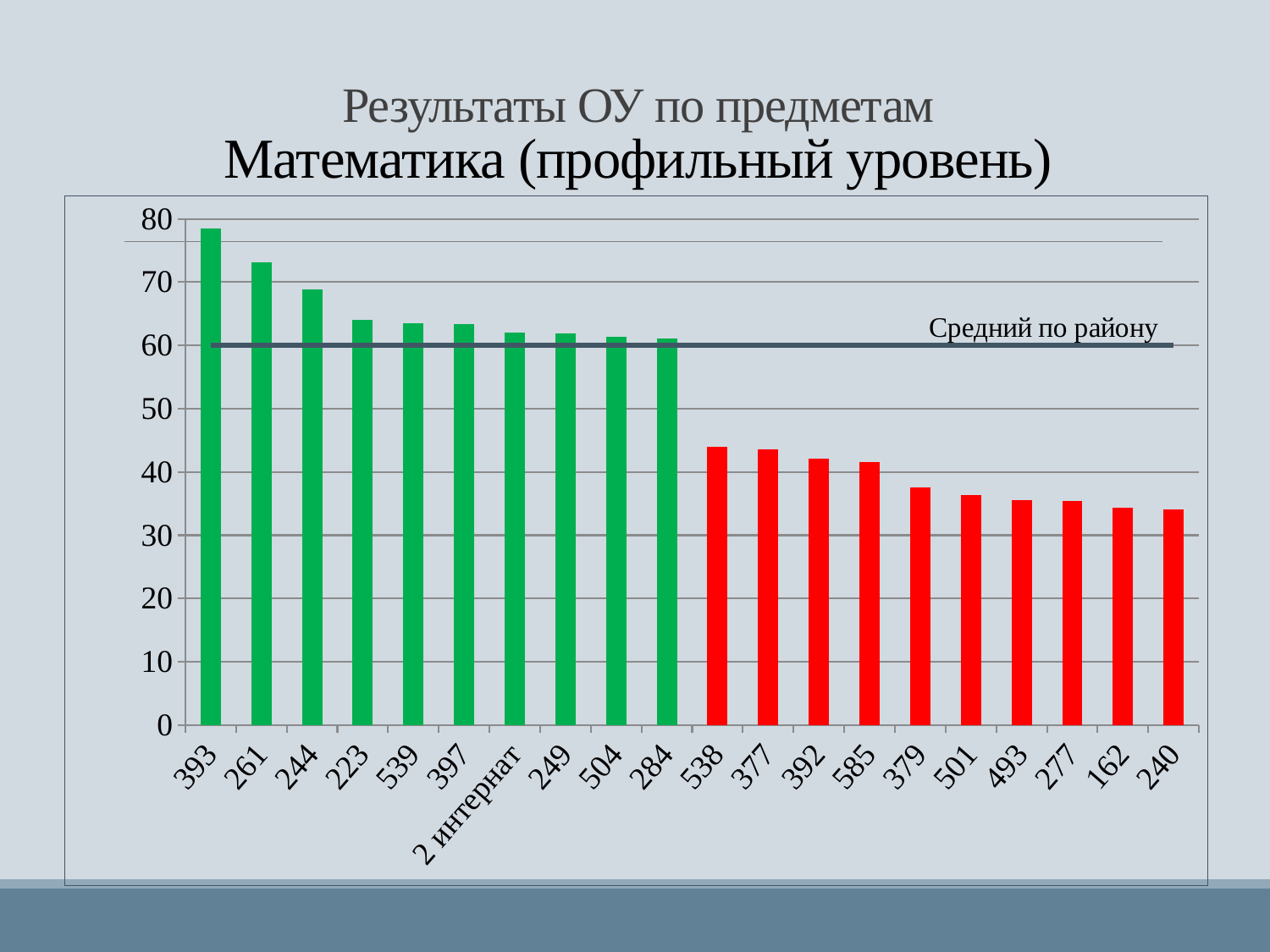
Is the value for 244 greater or less than 70? less Which category has the highest value on the chart? 393 Is the value for 379 greater or less than 40? less Is the value for 240 greater or less than 40? less How many categories (bars) are shown on the chart? 20 Which has a larger value, 261 or 377? 261 What is the label of the horizontal line drawn across the chart? Средний по району Do the bar values rise or fall from left to right along the x axis? fall What kind of chart is shown on the slide? bar chart